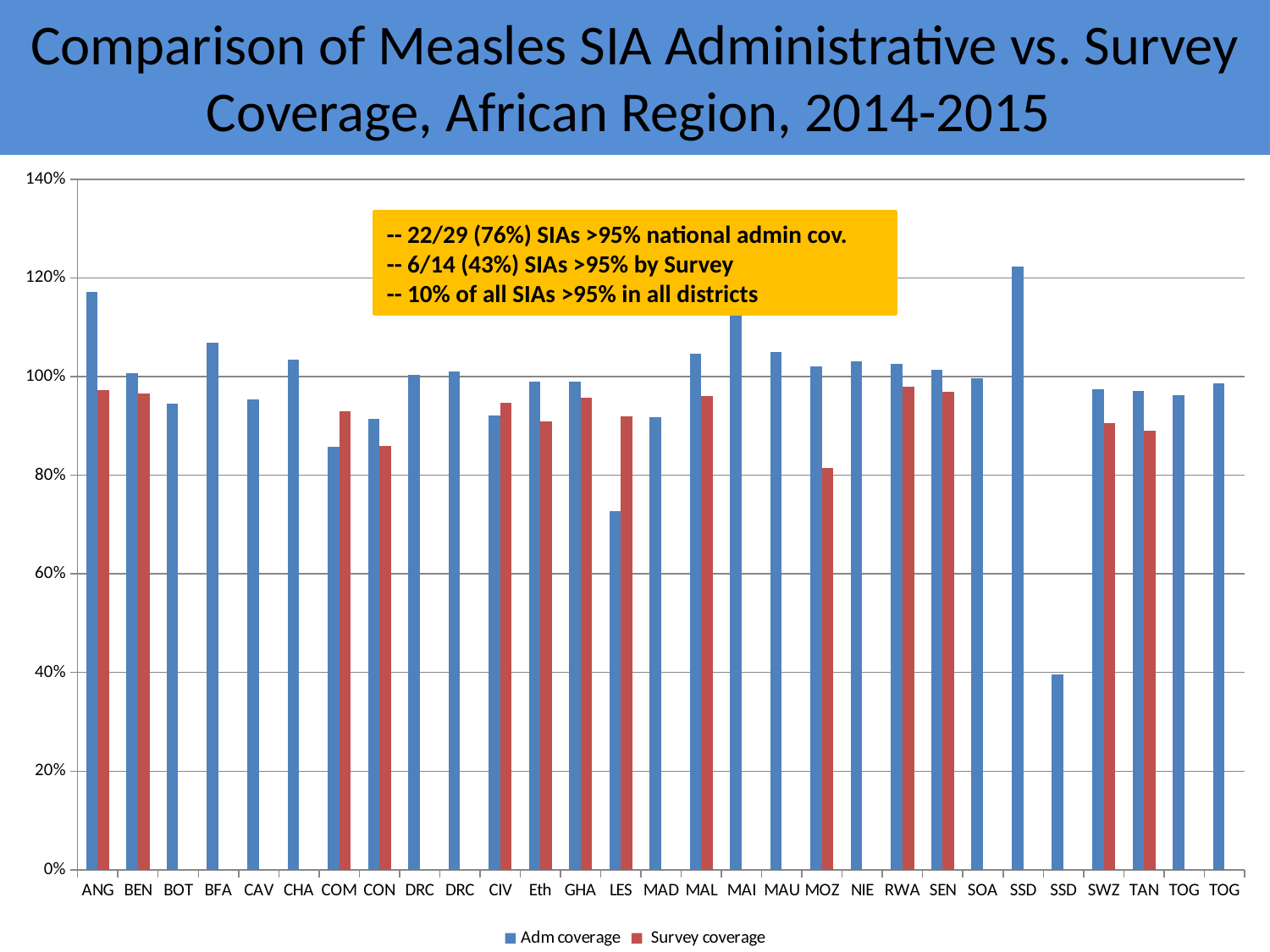
For LES, which is larger: Adm coverage or Survey coverage? Survey coverage Is the Adm coverage value for MAI greater or less than 100%? greater Which category has the highest Adm coverage bar? SSD (the first SSD) How many series does the legend list? 2 For ANG, which is larger: Adm coverage or Survey coverage? Adm coverage How many categories are shown along the x axis? 29 Is the Adm coverage value for ANG greater or less than 100%? greater Is the Survey coverage value for MOZ greater or less than 100%? less What are the two series named in the legend? Adm coverage and Survey coverage Which category has the lowest Adm coverage bar? SSD (the second SSD) What kind of chart is shown on the slide? bar chart